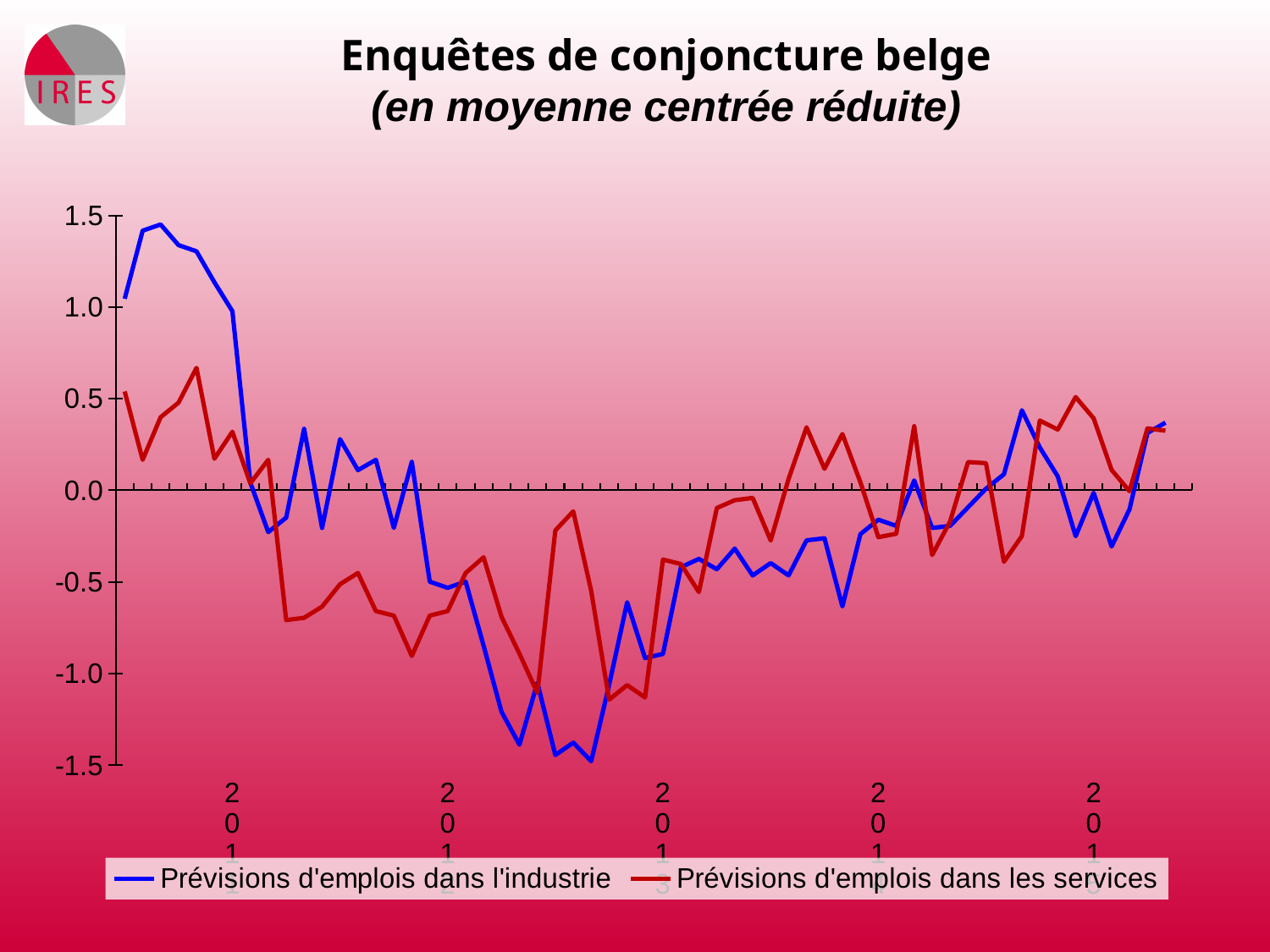
Is the highest value reached by the 'Prévisions d'emplois dans les services' series greater or less than 0.5? greater Is the lowest value reached by the 'Prévisions d'emplois dans les services' series greater or less than -0.5? less Is the lowest value reached by the 'Prévisions d'emplois dans l'industrie' series greater or less than -1.0? less How many year labels are shown on the x axis? 5 How many series does the legend list? 2 What kind of chart is shown on the slide? line chart What is the title of the chart? Enquêtes de conjoncture belge (en moyenne centrée réduite) Which series is drawn in blue? Prévisions d'emplois dans l'industrie Which series reaches the highest value on the chart, 'Prévisions d'emplois dans l'industrie' or 'Prévisions d'emplois dans les services'? Prévisions d'emplois dans l'industrie Which series reaches the lowest value on the chart, 'Prévisions d'emplois dans l'industrie' or 'Prévisions d'emplois dans les services'? Prévisions d'emplois dans l'industrie Does the 'Prévisions d'emplois dans l'industrie' series rise or fall between its peak near the start of the chart and the 2012 label? fall